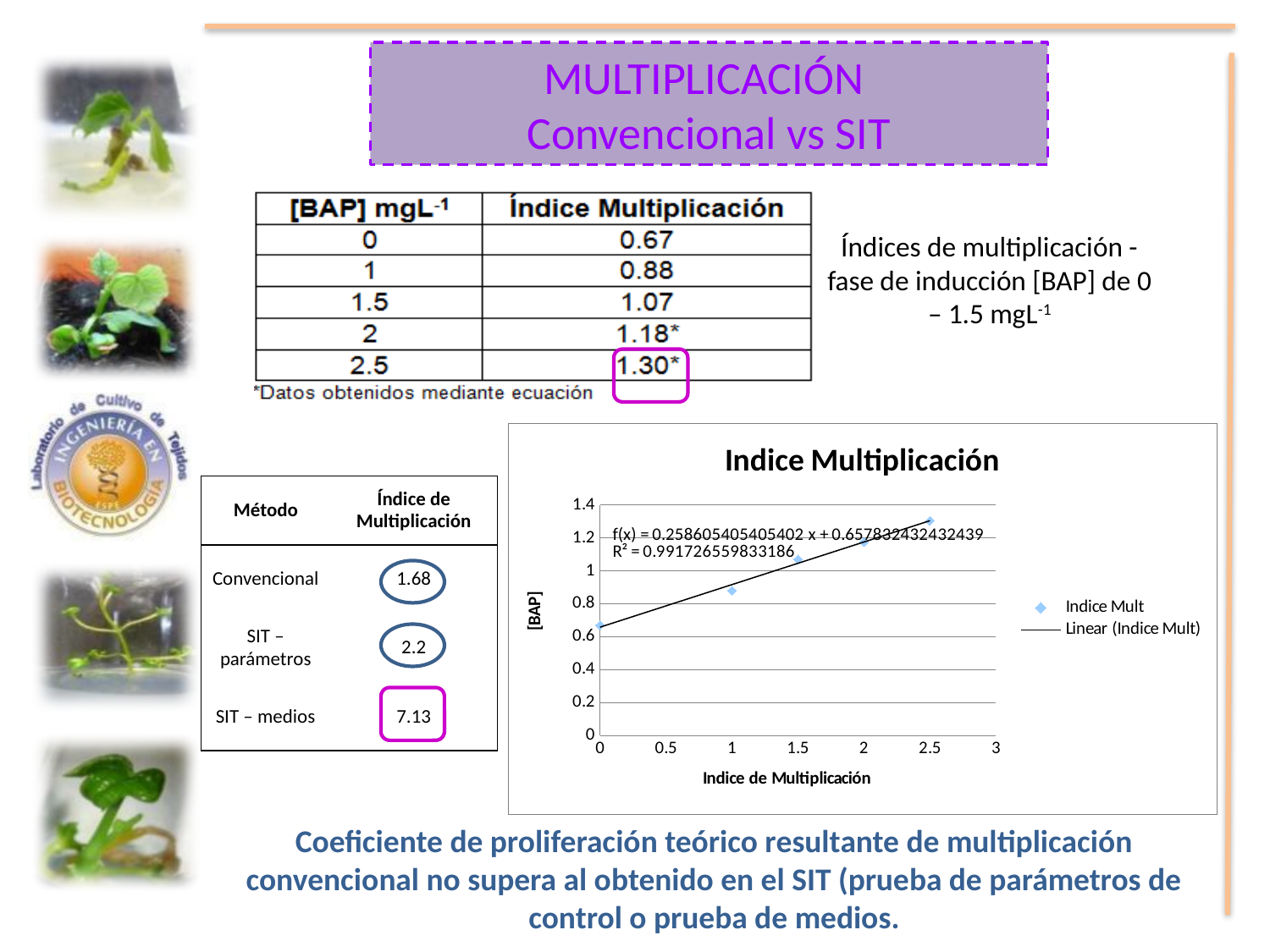
How many data points are plotted in the chart? 5 What R² value is printed on the chart for the linear trendline? 0.991726559833186 How many entries does the chart legend list? 2 Which point has the larger value, the one at x = 1 or the one at x = 2? x = 2 Is the value of the point at x = 0 greater or less than 0.8? less What kind of chart is shown on the slide? scatter chart What is the title of the chart? Indice Multiplicación At which x value is the plotted point highest? 2.5 Do the plotted values rise or fall as the x value increases? rise Is the value of the point at x = 2 greater or less than 1? greater At which x value is the plotted point lowest? 0 Is the value of the point at x = 2.5 greater or less than 1.2? greater